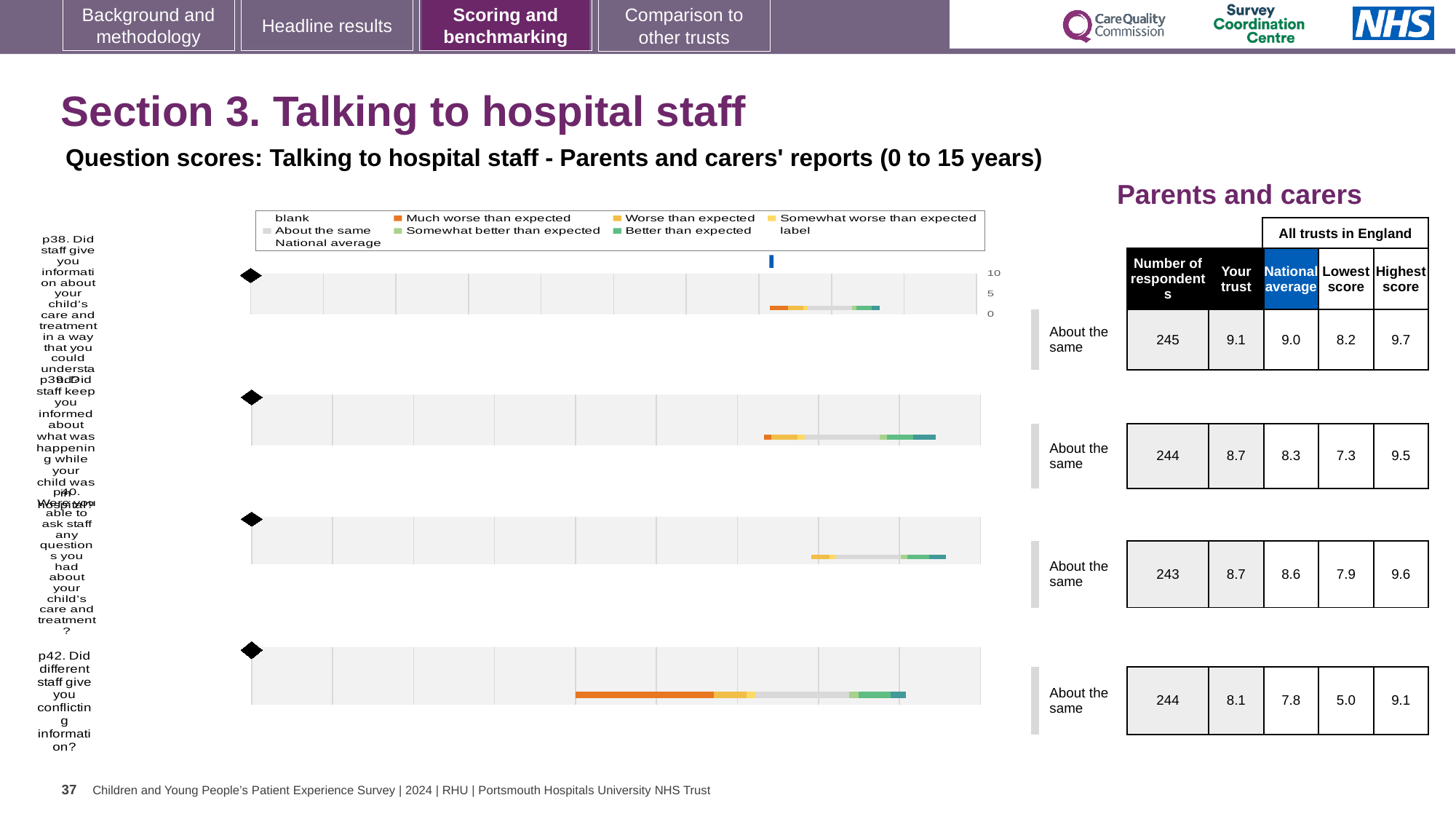
For the p39 chart, which is larger: the 'Your trust' score or the national average? Your trust For the p42 chart (Did different staff give you conflicting information?), what is the national average score? 7.8 Which question has the highest 'Your trust' score? p38 For the p38 chart, what is the 'Your trust' score shown in the table? 9.1 How many question charts (p38, p39, p40, p42) are shown on the slide? 4 What kind of chart is used to show the benchmarking results for each question on this slide? bar chart For the p40 chart (Were you able to ask staff any questions you had about your child's care and treatment?), what is the difference between the highest score and the lowest score? 1.7 Which question has the lowest 'Lowest score' across all trusts in England? p42 In the chart legend, which colour represents 'Much worse than expected'? orange What benchmarking category is shown next to the chart for p38 (Did staff give you information about your child's care and treatment in a way that you could understand)? About the same For the p42 chart, what is the difference between the 'Your trust' score and the national average? 0.3 For the p39 chart (Did staff keep you informed about what was happening while your child was in hospital?), how many respondents are listed? 244